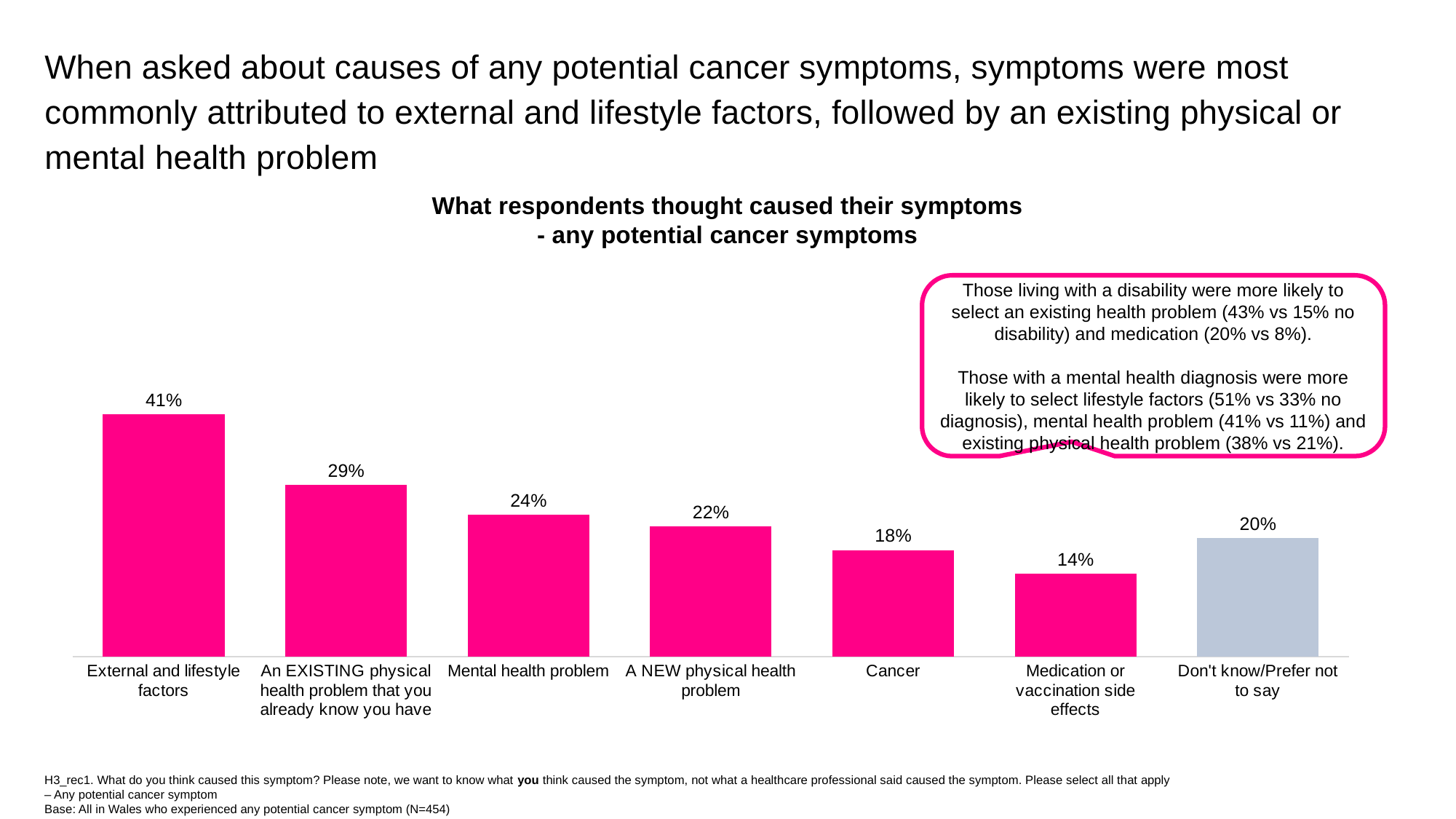
Which bar is coloured differently (grey) from the other bars? Don't know/Prefer not to say What percentage selected 'Medication or vaccination side effects'? 14% What is the title of the chart? What respondents thought caused their symptoms - any potential cancer symptoms What percentage of respondents attributed their symptoms to external and lifestyle factors? 41% What type of chart is shown on the slide? Bar chart How many categories are shown in the chart? 7 What is the value for 'Don't know/Prefer not to say'? 20% Which category has the lowest value in the chart? Medication or vaccination side effects What is the difference between the values for 'External and lifestyle factors' and 'An EXISTING physical health problem that you already know you have'? 12% Which is larger: the value for 'Mental health problem' or the value for 'A NEW physical health problem'? Mental health problem What is the value for 'Cancer' in the chart? 18% Which category has the highest value in the chart? External and lifestyle factors